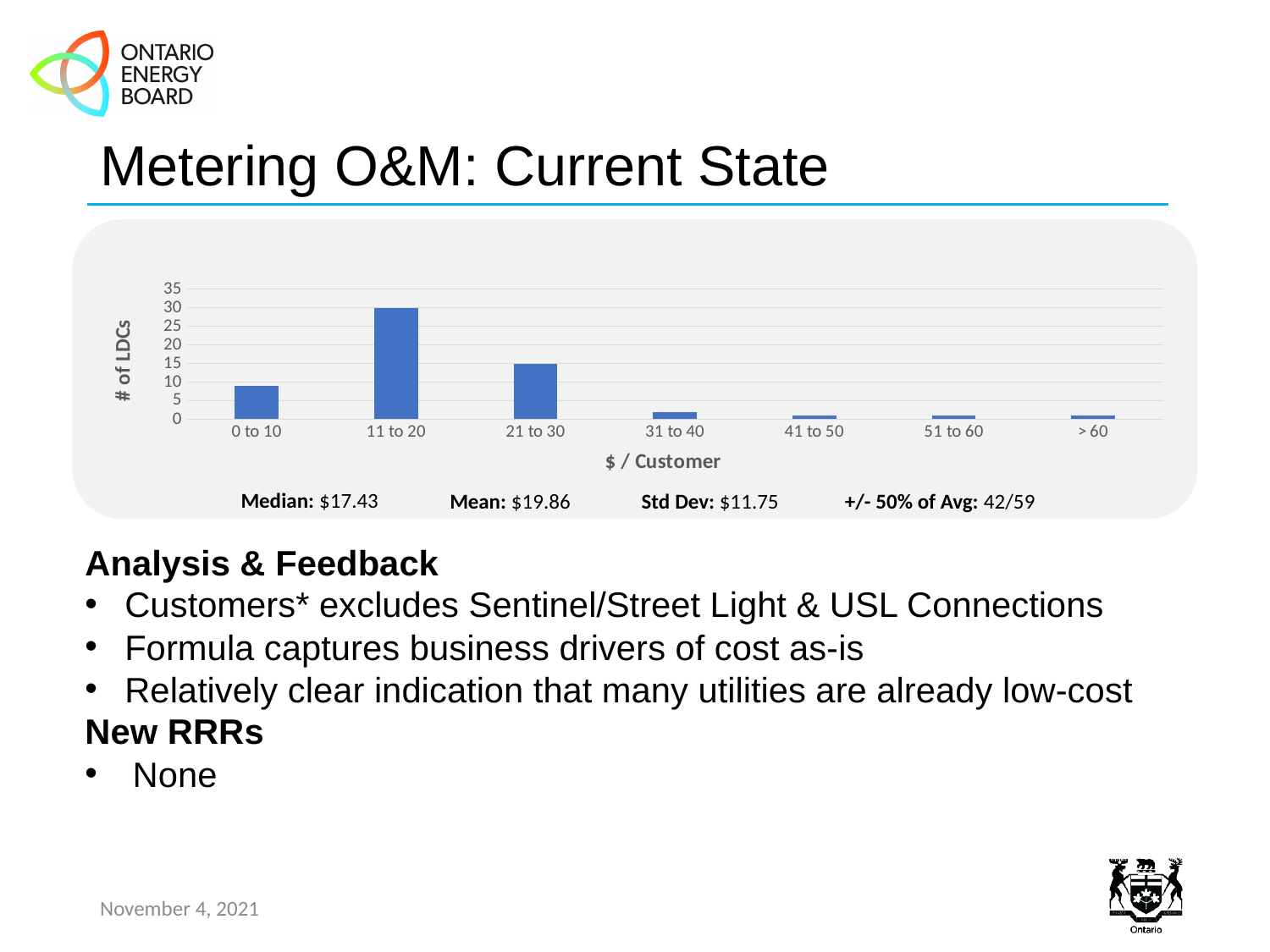
How many $ / Customer categories are shown on the x axis? 7 Which $ / Customer category has the highest number of LDCs? 11 to 20 Is the number of LDCs in the 31 to 40 category greater or less than 5? less How many LDCs are in the 21 to 30 $ / Customer category? 15 Moving from the 11 to 20 category to the > 60 category, do the bar values rise or fall? fall Which has more LDCs: the 0 to 10 category or the 21 to 30 category? 21 to 30 Which has more LDCs: the 11 to 20 category or the 21 to 30 category? 11 to 20 What kind of chart is shown on the slide? bar chart Is the number of LDCs in the 0 to 10 category greater or less than 5? greater How many LDCs are in the 11 to 20 $ / Customer category? 30 What is the title of the chart's x axis? $ / Customer